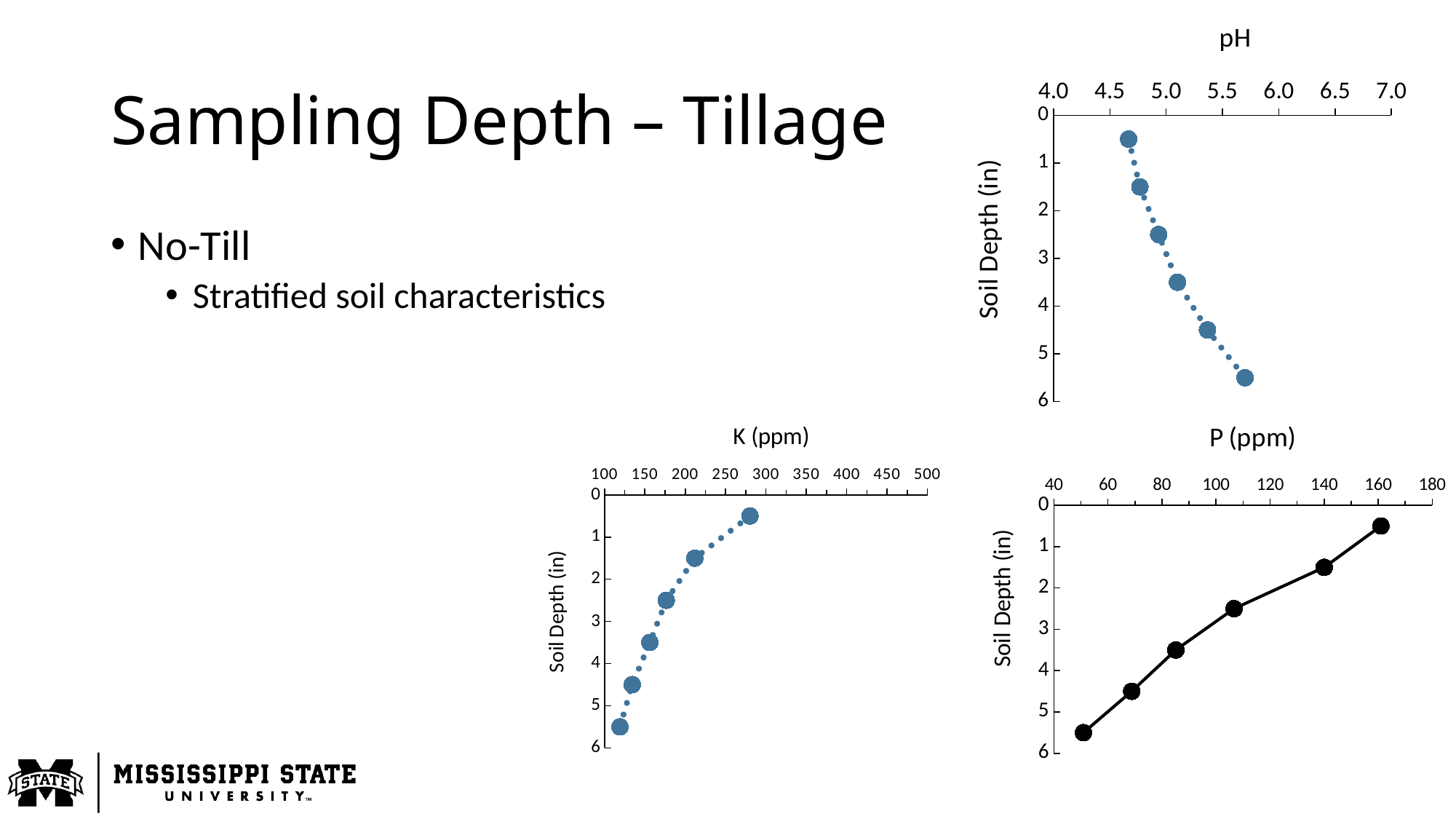
How many data points are plotted on the P (ppm) chart? 6 On the P (ppm) chart, is the P value at a soil depth of 5.5 in greater or less than 60? less On the K (ppm) chart, is the K value at a soil depth of 5.5 in greater or less than 150? less What kind of chart is the pH chart? scatter chart On the K (ppm) chart, at which soil depth is the K value highest? 0.5 in On the pH chart, is the pH value at a soil depth of 0.5 in greater or less than 5.0? less On the P (ppm) chart, does the P value rise or fall as soil depth increases? fall On the P (ppm) chart, which has the larger P value: the point at 1.5 in depth or the point at 3.5 in depth? 1.5 in On the pH chart, does the pH value rise or fall as soil depth increases? rise How many data points are plotted on the K (ppm) chart? 6